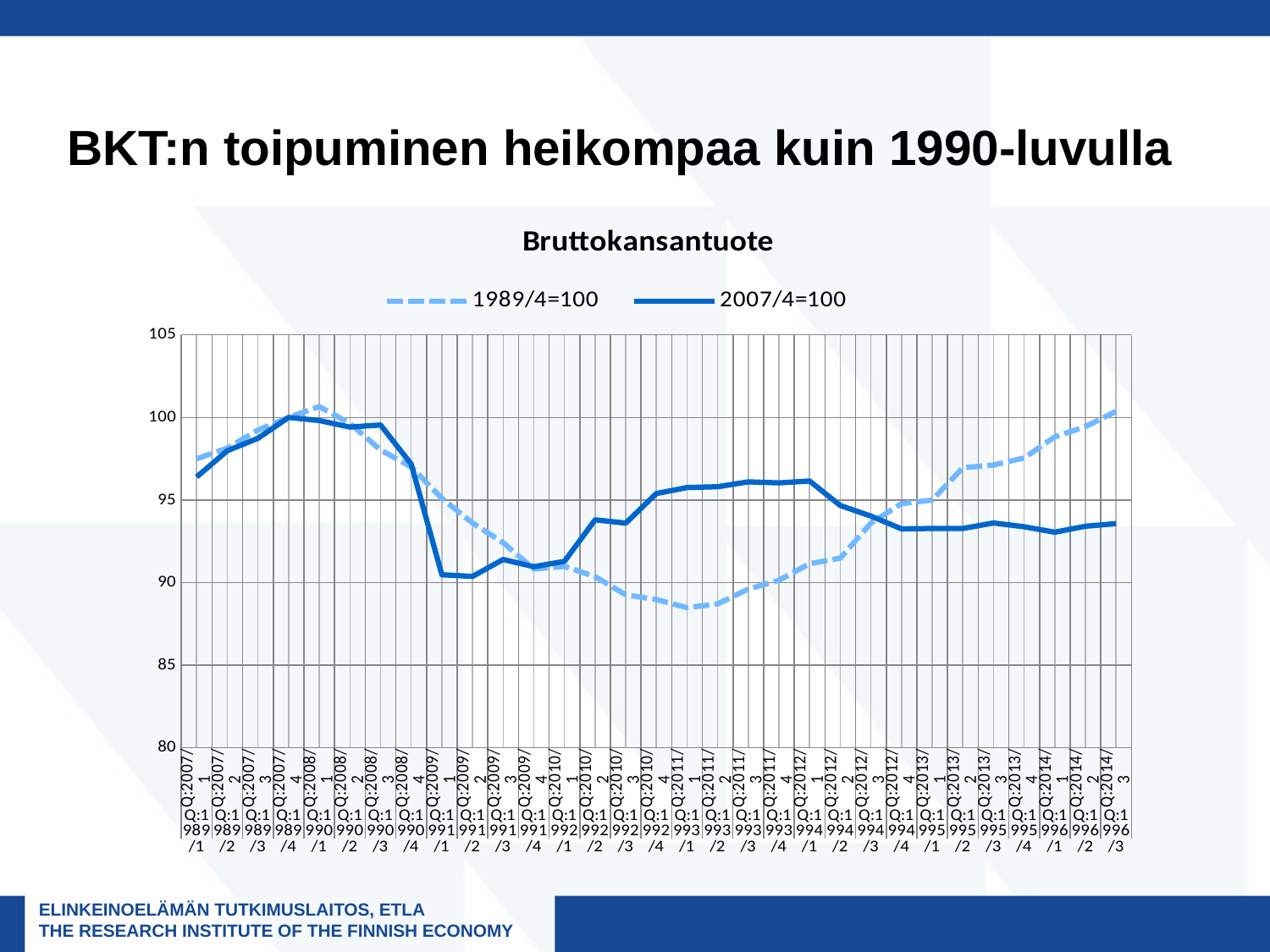
What kind of chart is shown on the slide? line chart What is the title of the chart? Bruttokansantuote Is the value of the 2007/4=100 series at Q:2014/3 greater or less than 95? less At Q:2011/1, which series has the higher value, 1989/4=100 or 2007/4=100? 2007/4=100 Which series is drawn with a dashed line in the chart? 1989/4=100 Is the value of the 1989/4=100 series at Q:2011/1 greater or less than 90? less Is the value of the 1989/4=100 series at Q:2014/3 greater or less than 95? greater At Q:2014/3, which series has the higher value, 1989/4=100 or 2007/4=100? 1989/4=100 Which series reaches the lowest value shown on the chart? 1989/4=100 Does the 1989/4=100 series rise or fall between Q:2011/1 and Q:2014/3? rise How many series does the legend of the chart list? 2